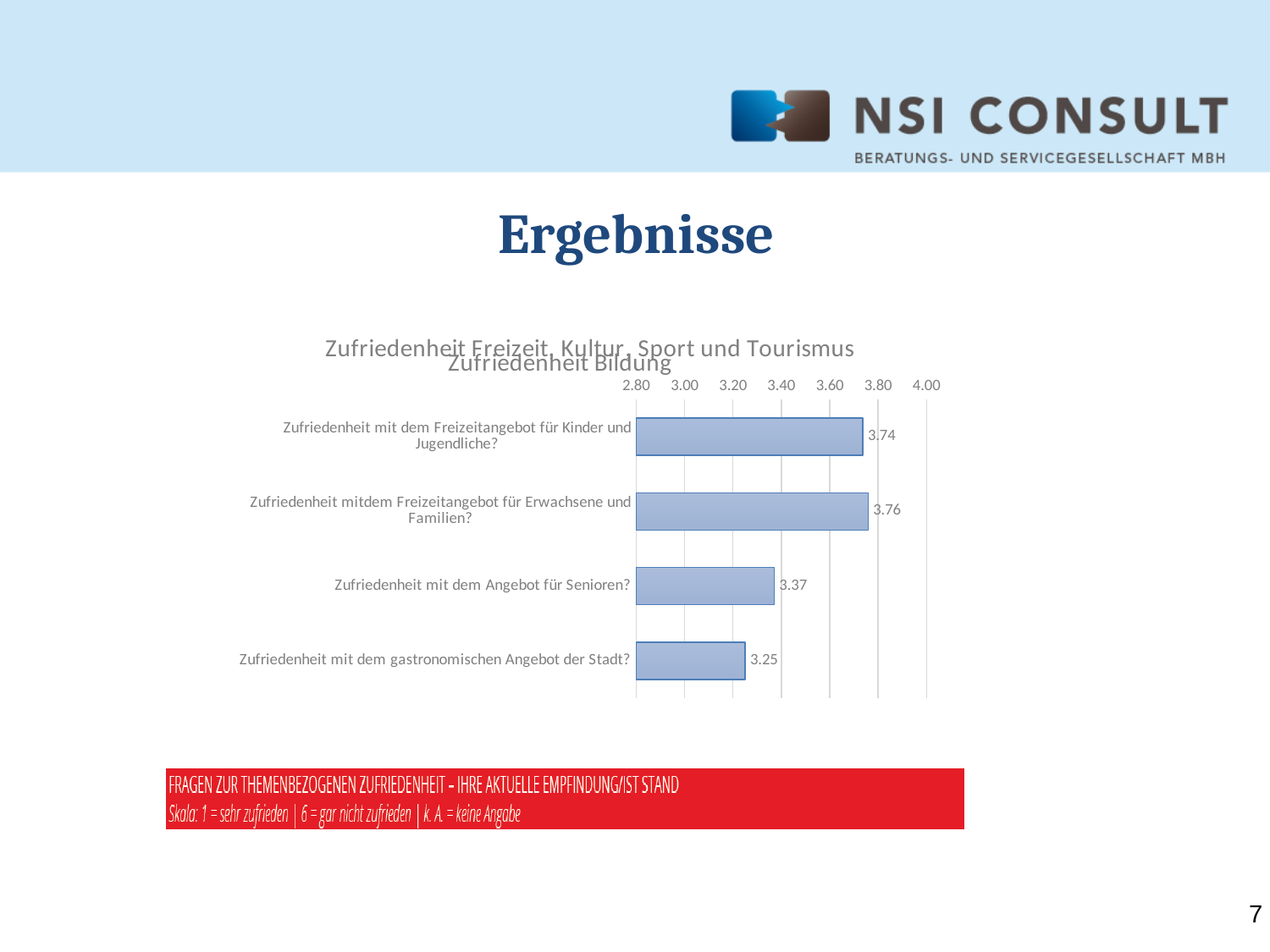
Is the value for "Zufriedenheit mit dem Freizeitangebot für Kinder und Jugendliche?" greater or less than 3.60? greater What is the value for "Zufriedenheit mitdem Freizeitangebot für Erwachsene und Familien?"? 3.76 How many categories are shown in the chart? 4 What is the value for "Zufriedenheit mit dem Freizeitangebot für Kinder und Jugendliche?"? 3.74 Which is larger: the value for "Angebot für Senioren" or the value for "gastronomischen Angebot der Stadt"? Angebot für Senioren Is the value for "Zufriedenheit mit dem gastronomischen Angebot der Stadt?" greater or less than 3.40? less What kind of chart is shown on the slide? bar chart Which category has the lowest value? Zufriedenheit mit dem gastronomischen Angebot der Stadt? What is the difference between the values for "Freizeitangebot für Kinder und Jugendliche" and "Angebot für Senioren"? 0.37 What is the value for "Zufriedenheit mit dem gastronomischen Angebot der Stadt?"? 3.25 What is the value for "Zufriedenheit mit dem Angebot für Senioren?"? 3.37 What is the difference between the values for "Freizeitangebot für Erwachsene und Familien" and "gastronomischen Angebot der Stadt"? 0.51